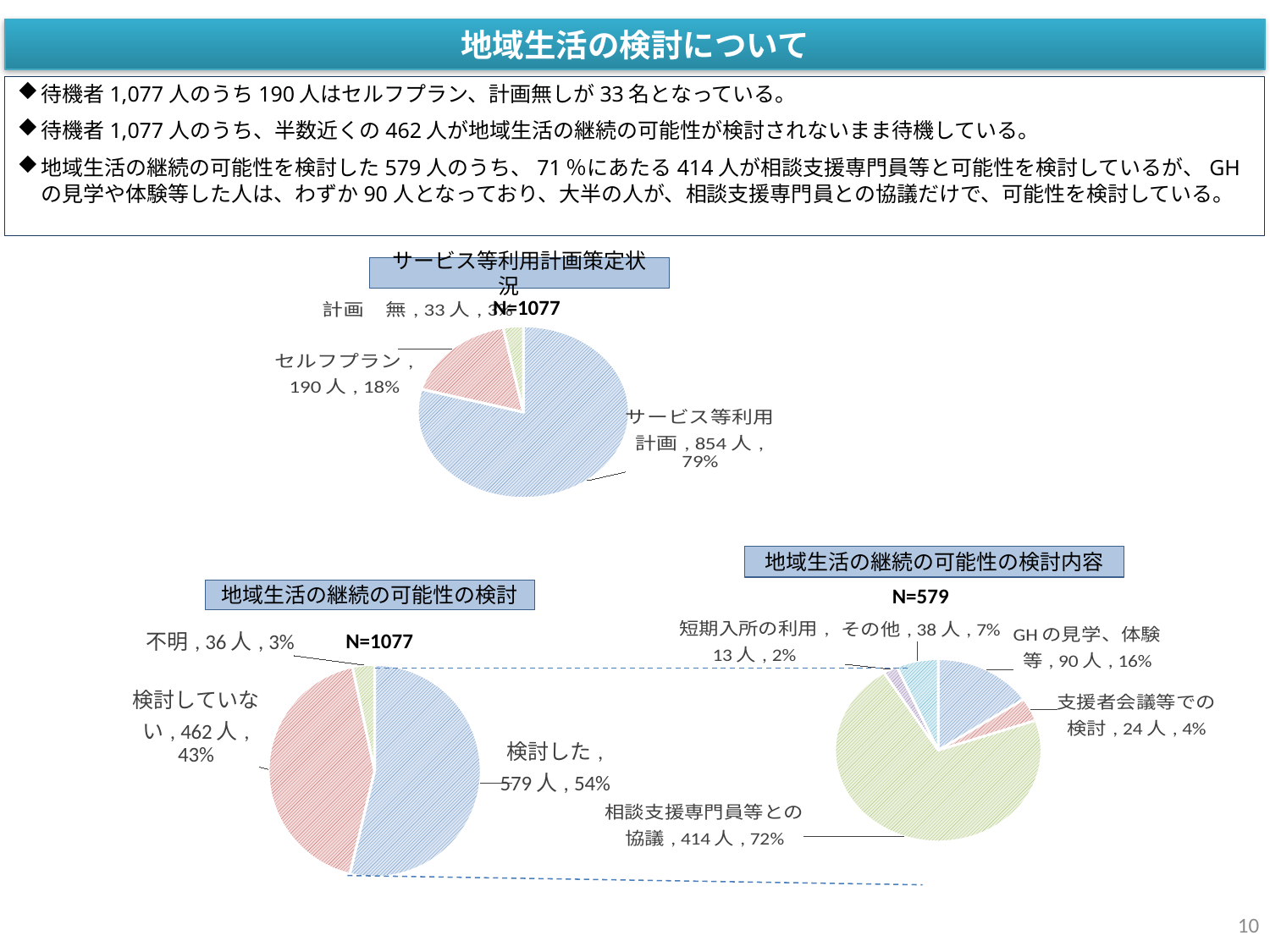
In the chart titled 地域生活の継続の可能性の検討内容, how many people are in the 相談支援専門員等との協議 category? 414人 In the chart titled 地域生活の継続の可能性の検討内容, which category has the smallest slice? 短期入所の利用 In the chart titled 地域生活の継続の可能性の検討, which is larger, 検討した or 検討していない? 検討した What kind of chart is the chart titled 地域生活の継続の可能性の検討内容? pie chart What is the N value shown for the chart titled 地域生活の継続の可能性の検討内容? N=579 In the chart titled サービス等利用計画策定状況, which category has the largest slice? サービス等利用計画 In the chart titled 地域生活の継続の可能性の検討, what percentage share does 検討していない have? 43% In the chart titled 地域生活の継続の可能性の検討, how many people are in the 検討した category? 579人 In the chart titled サービス等利用計画策定状況, what percentage share does セルフプラン have? 18% In the chart titled サービス等利用計画策定状況, what is the difference in people between サービス等利用計画 and セルフプラン? 664人 In the chart titled 地域生活の継続の可能性の検討内容, what is the difference in people between GHの見学、体験等 and 支援者会議等での検討? 66人 In the chart titled 地域生活の継続の可能性の検討内容, how many categories are shown? 5